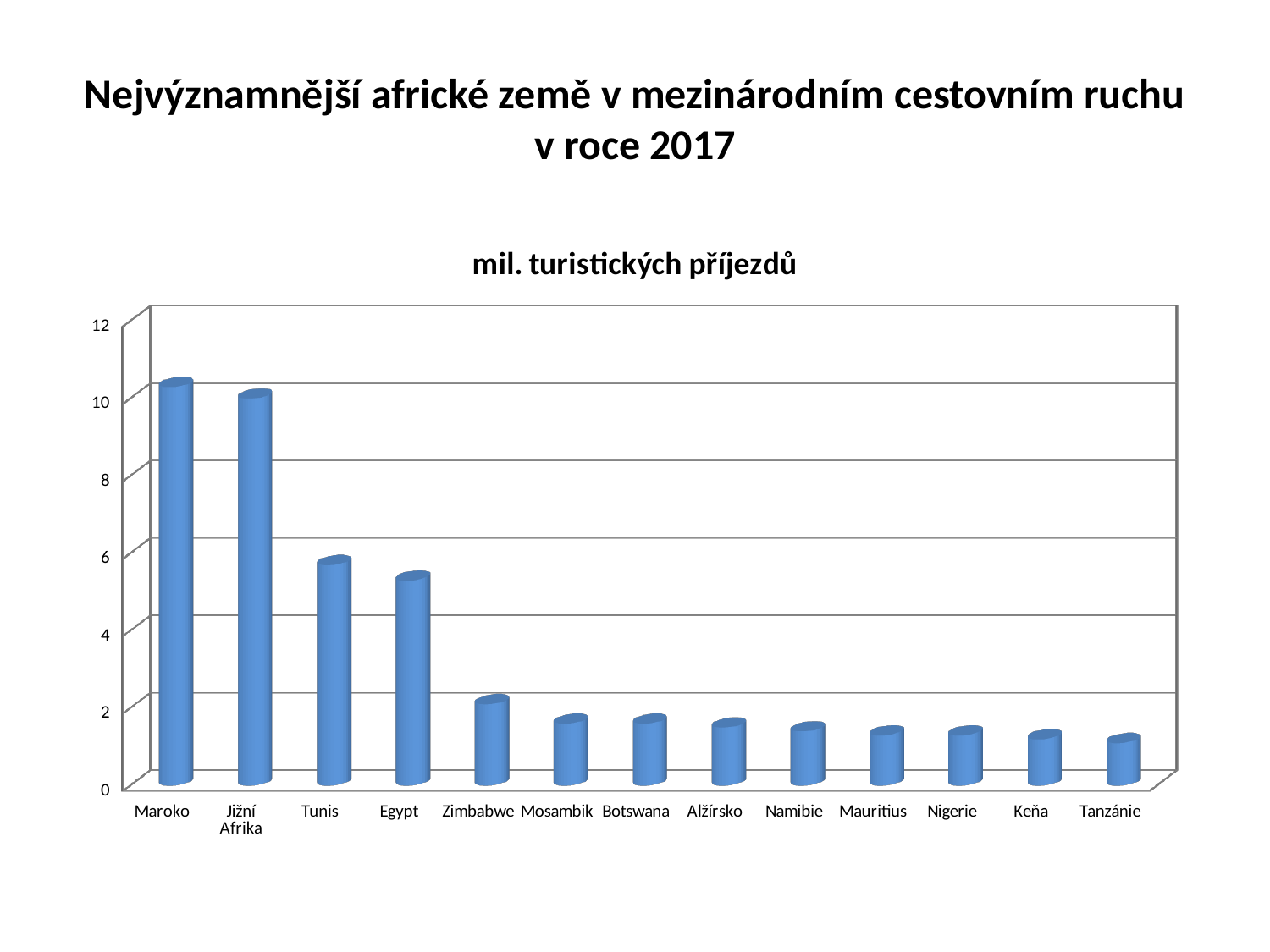
What kind of chart is shown on the slide? bar chart Is the value for Egypt greater or less than 4? greater Is the value for Zimbabwe greater or less than 4? less Is the value for Mosambik greater or less than 2? less Which has the larger value, Tunis or Egypt? Tunis What is the title of the chart? mil. turistických příjezdů How many countries are shown on the x axis of the chart? 13 Do the values rise or fall from left to right along the x axis? fall Which country has the highest value in the chart? Maroko